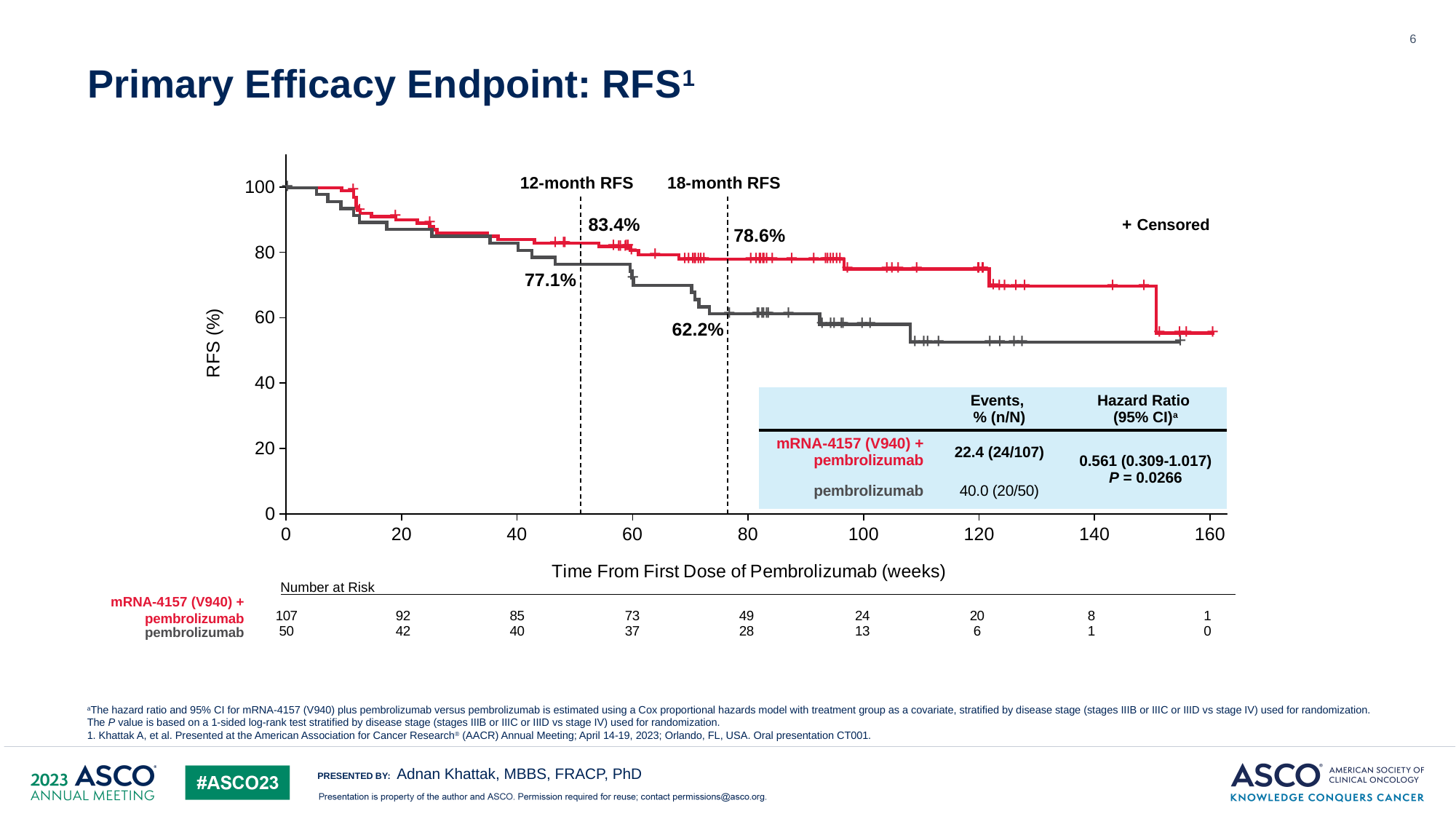
How many patients were at risk in the pembrolizumab arm at week 80? 28 Is the RFS value for the pembrolizumab curve at week 140 greater or less than 60? less Do the RFS curves rise or fall as time from first dose increases? fall What is the 12-month RFS for the mRNA-4157 (V940) + pembrolizumab arm? 83.4% What is the 18-month RFS for the pembrolizumab arm? 62.2% What is the difference between the two arms' 18-month RFS values? 16.4 percentage points How many patients were at risk in the mRNA-4157 (V940) + pembrolizumab arm at week 0? 107 What is the difference between the two arms' 12-month RFS values? 6.3 percentage points What is the hazard ratio (95% CI) shown in the table? 0.561 (0.309-1.017) What is the label of the x axis? Time From First Dose of Pembrolizumab (weeks) What is the event rate, % (n/N), for the pembrolizumab arm? 40.0 (20/50) Which arm has the higher 18-month RFS? mRNA-4157 (V940) + pembrolizumab